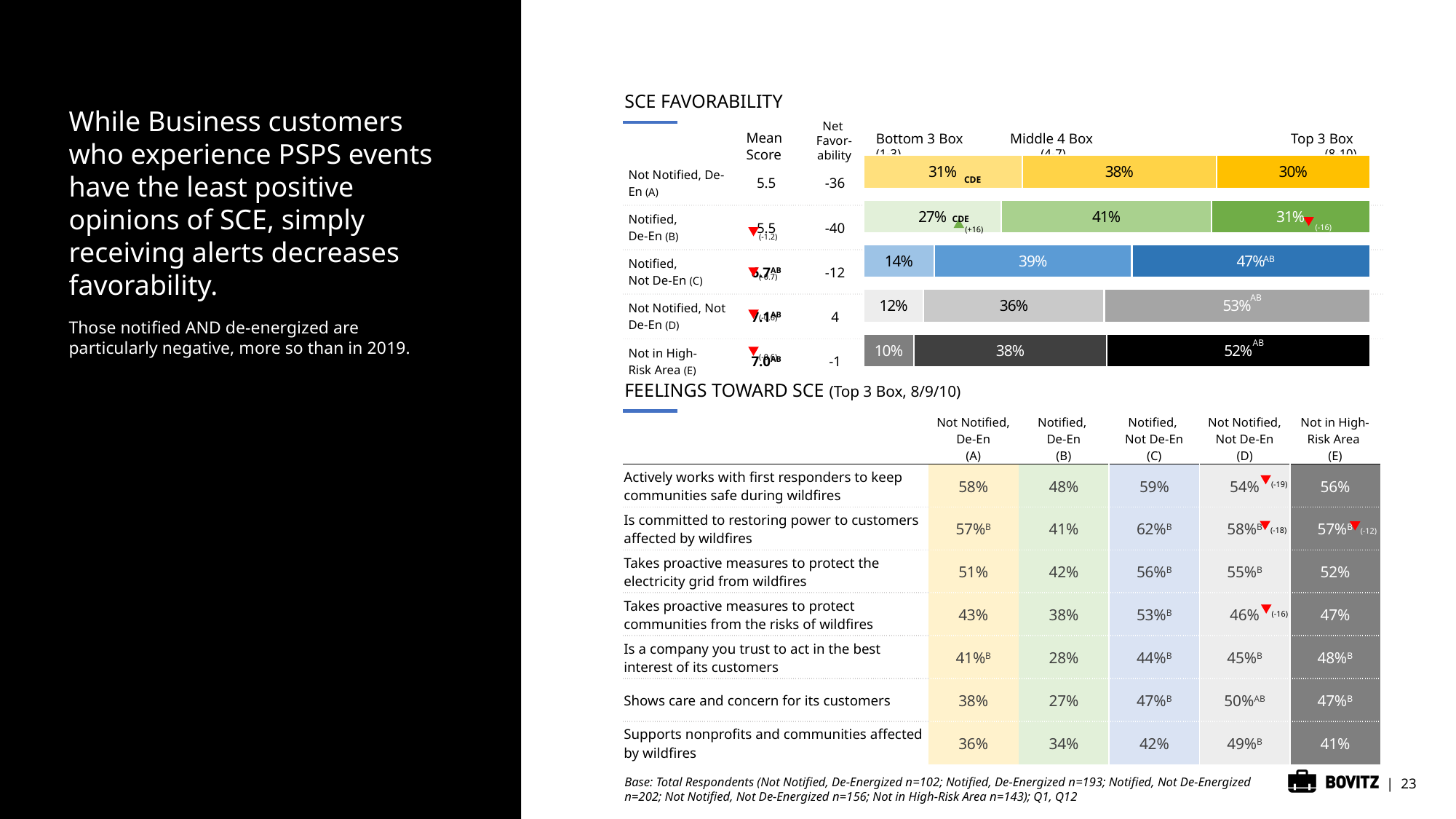
What kind of chart is used in the SCE FAVORABILITY section? Stacked bar chart In the SCE FAVORABILITY chart, which group has the highest Top 3 Box value? Not Notified, Not De-En (D) In the SCE FAVORABILITY chart, what is the Top 3 Box value for Notified, Not De-En (C)? 47% In the SCE FAVORABILITY chart, which has the larger Middle 4 Box value: Notified, De-En (B) or Notified, Not De-En (C)? Notified, De-En (B) In the SCE FAVORABILITY chart, which group has the lowest Bottom 3 Box value? Not in High-Risk Area (E) How many customer groups (bars) are shown in the SCE FAVORABILITY chart? 5 How many segments (box groupings) make up each bar in the SCE FAVORABILITY chart? 3 What is the title of the stacked bar chart on the slide? SCE FAVORABILITY In the SCE FAVORABILITY chart, what is the Net Favorability for Notified, De-En (B)? -40 In the SCE FAVORABILITY chart, what is the difference in Top 3 Box values between Not Notified, Not De-En (D) and Not Notified, De-En (A)? 23 percentage points In the SCE FAVORABILITY chart, what is the Bottom 3 Box value for Not Notified, De-En (A)? 31% In the SCE FAVORABILITY chart, what is the total of the three segments for Notified, Not De-En (C)? 100%